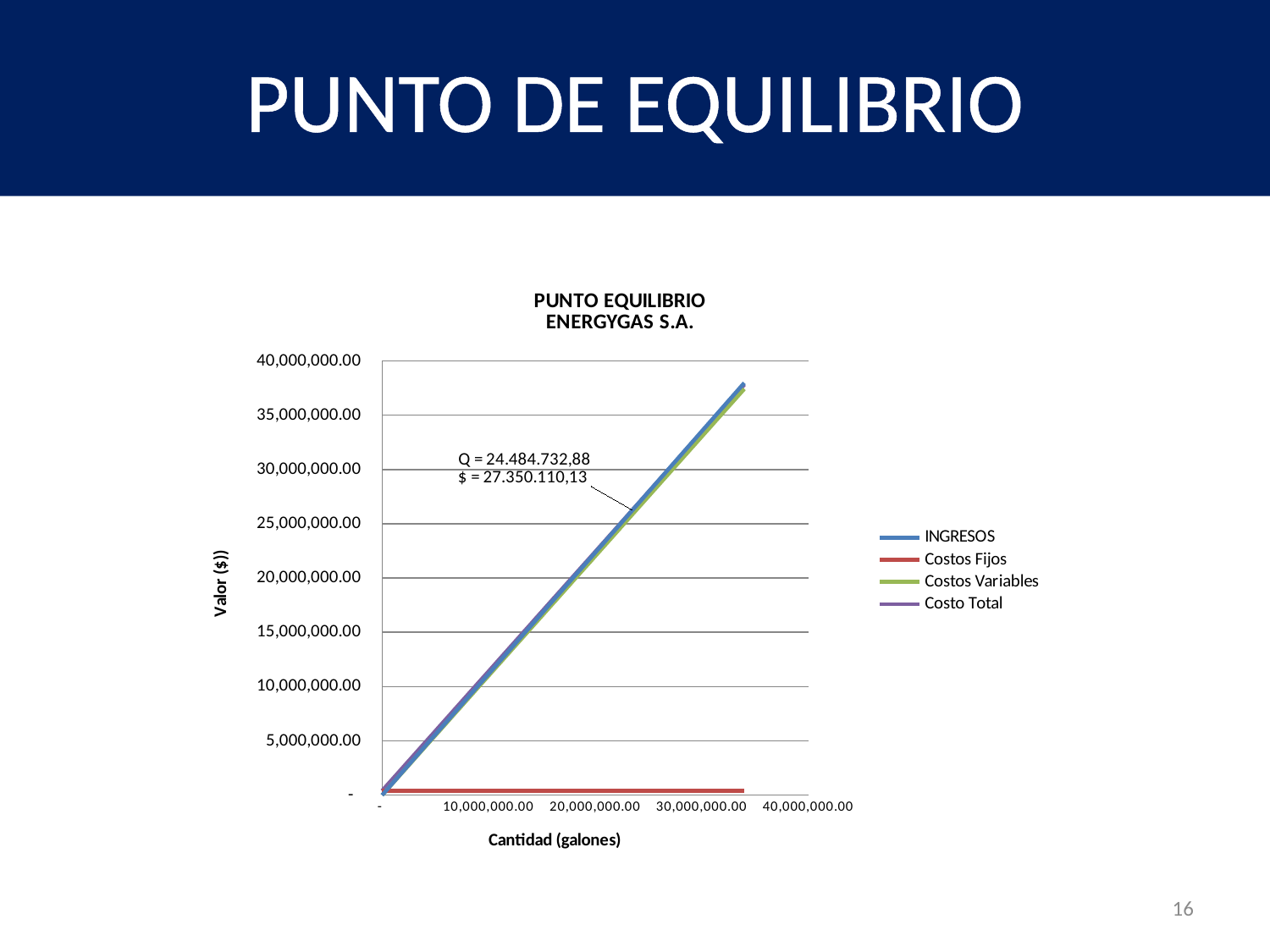
What break-even quantity (Q) is annotated on the chart? 24.484.732,88 What is the label of the x axis of the chart? Cantidad (galones) Which series is drawn in red in the chart? Costos Fijos What is the title of the chart? PUNTO EQUILIBRIO ENERGYGAS S.A. Which series has the lowest values across the chart? Costos Fijos How many series does the legend of the chart list? 4 What break-even value ($) is annotated on the chart? 27.350.110,13 Is the value of INGRESOS at 30,000,000.00 gallons greater or less than 25,000,000.00? greater What kind of chart is shown on the slide? Line chart Do the INGRESOS values rise or fall as the quantity increases along the x axis? Rise At 30,000,000.00 gallons, which is larger: INGRESOS or Costos Fijos? INGRESOS Is the value of Costos Fijos at 20,000,000.00 gallons greater or less than 5,000,000.00? less